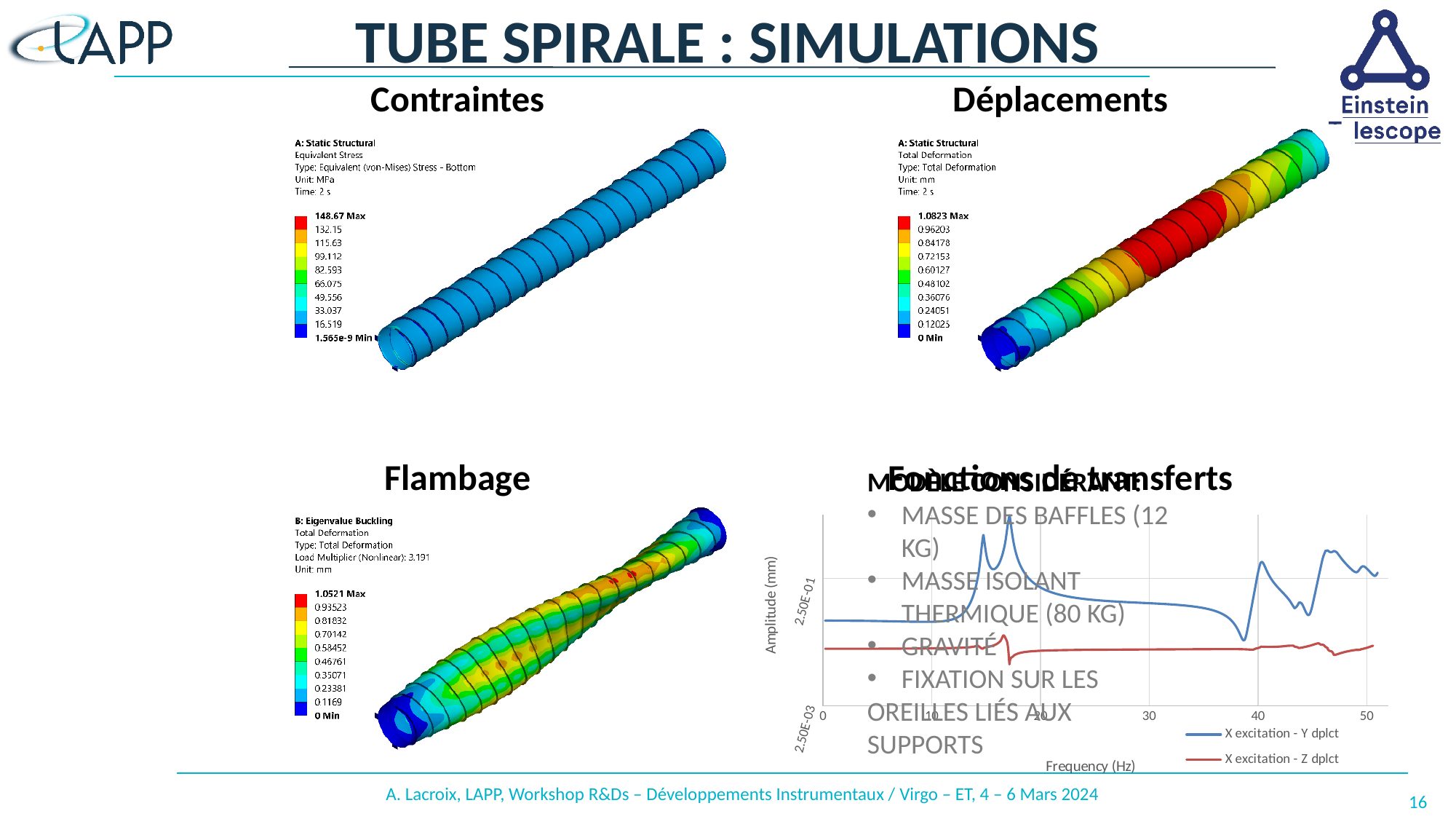
In the 'Fonctions de transferts' chart, what is the label of the blue series in the legend? X excitation - Y dplct How many series does the legend of the 'Fonctions de transferts' chart list? 2 What kind of chart is the 'Fonctions de transferts' chart at the bottom right of the slide? line chart In the 'Fonctions de transferts' chart, what is the label of the red series in the legend? X excitation - Z dplct How many tick labels are shown on the x axis of the 'Fonctions de transferts' chart? 6 In the 'Fonctions de transferts' chart, is the peak amplitude of the 'X excitation - Y dplct' series greater or less than 2.50E-01? greater What is the highest frequency value labelled on the x axis of the 'Fonctions de transferts' chart? 50 In the 'Fonctions de transferts' chart, is the amplitude of the 'X excitation - Z dplct' series greater or less than 2.50E-03? greater What is the x-axis title of the 'Fonctions de transferts' chart? Frequency (Hz) In the 'Fonctions de transferts' chart, which series has the larger amplitude across the frequency range, 'X excitation - Y dplct' or 'X excitation - Z dplct'? X excitation - Y dplct In the 'Fonctions de transferts' chart, is the amplitude of the 'X excitation - Z dplct' series greater or less than 2.50E-01? less